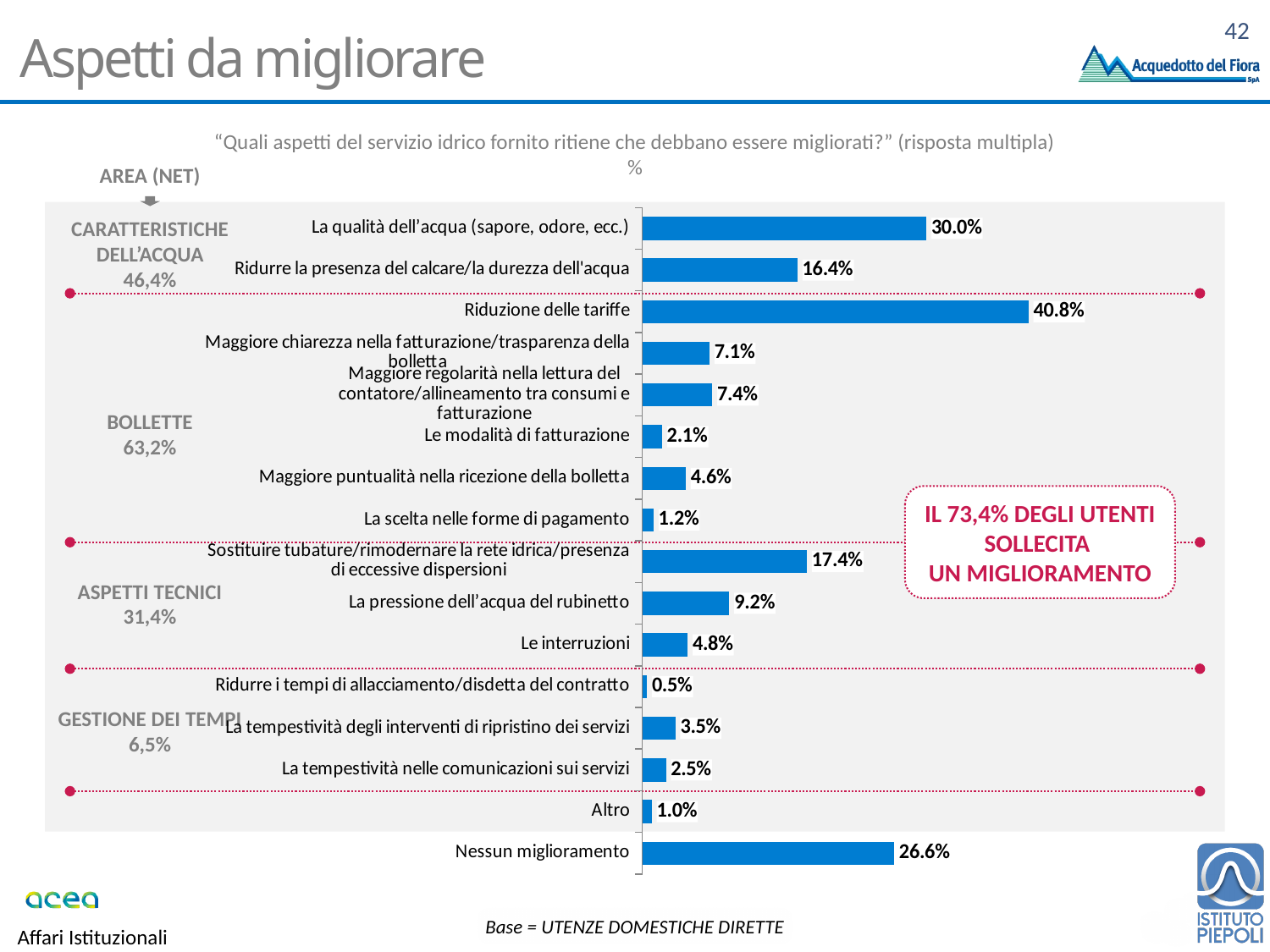
What is the net percentage shown for the BOLLETTE area? 63,2% Which is larger: "Sostituire tubature/rimodernare la rete idrica/presenza di eccessive dispersioni" or "Ridurre la presenza del calcare/la durezza dell'acqua"? Sostituire tubature/rimodernare la rete idrica/presenza di eccessive dispersioni What kind of chart is shown on the slide? Bar chart What is the value for "La pressione dell'acqua del rubinetto"? 9.2% What is the difference between "Riduzione delle tariffe" and "La qualità dell'acqua (sapore, odore, ecc.)"? 10.8 percentage points What is the value for "Ridurre la presenza del calcare/la durezza dell'acqua"? 16.4% What is the value for "Nessun miglioramento"? 26.6% Which category has the highest value? Riduzione delle tariffe What is the value for "Riduzione delle tariffe"? 40.8% What is the difference between "Sostituire tubature/rimodernare la rete idrica/presenza di eccessive dispersioni" and "La pressione dell'acqua del rubinetto"? 8.2 percentage points Which category has the lowest value? Ridurre i tempi di allacciamento/disdetta del contratto How many categories are plotted in the chart? 16